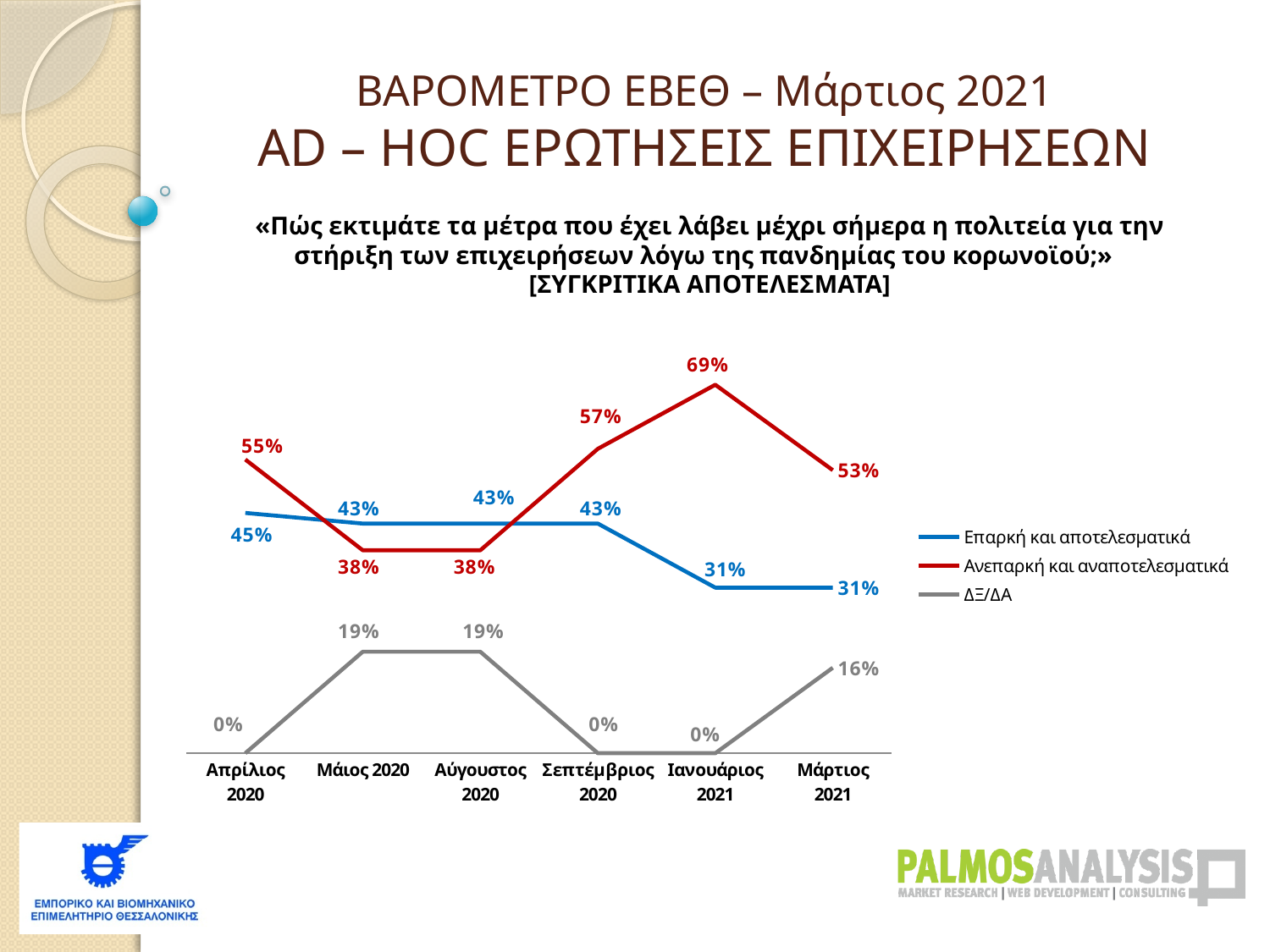
How many series does the legend list? 3 What is the value for 'Επαρκή και αποτελεσματικά' in Απρίλιος 2020? 45% What is the difference between 'Ανεπαρκή και αναποτελεσματικά' and 'Επαρκή και αποτελεσματικά' in Μάρτιος 2021? 22% How many time points are shown on the x axis? 6 In which time point does 'Ανεπαρκή και αναποτελεσματικά' have its lowest value? Μάιος 2020 and Αύγουστος 2020 What type of chart is shown on the slide? line chart Which colour is used for the 'ΔΞ/ΔΑ' series? grey Which series has the larger value in Μάιος 2020: 'Επαρκή και αποτελεσματικά' or 'Ανεπαρκή και αναποτελεσματικά'? Επαρκή και αποτελεσματικά Does the 'Επαρκή και αποτελεσματικά' series rise or fall from Απρίλιος 2020 to Μάρτιος 2021? fall What is the value for 'ΔΞ/ΔΑ' in Μάρτιος 2021? 16% What is the value for 'Ανεπαρκή και αναποτελεσματικά' in Ιανουάριος 2021? 69% In which time point does 'Ανεπαρκή και αναποτελεσματικά' reach its highest value? Ιανουάριος 2021